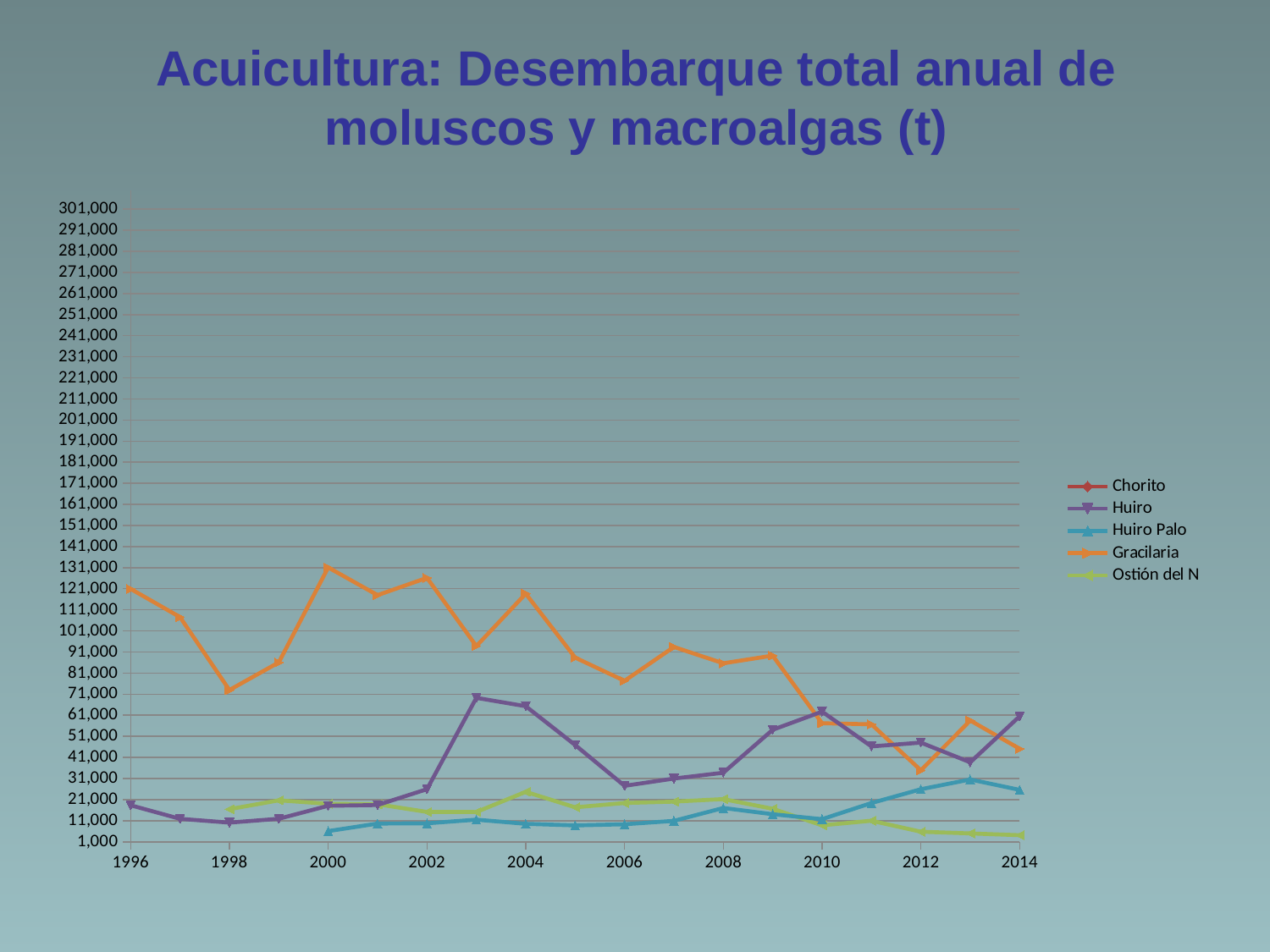
Does the Gracilaria series generally rise or fall from 1996 to 2014? fall Is the value for Gracilaria in 2000 greater or less than 121,000? greater How many year labels are shown on the x axis? 10 Which is larger in 2014, the value for Huiro or the value for Gracilaria? Huiro Is the value for Gracilaria in 1998 greater or less than 81,000? less Is the value for Huiro Palo in 2000 greater or less than 11,000? less Which series has the lowest value in 2014? Ostión del N In which year does the Gracilaria series reach its lowest value? 2012 What kind of chart is shown on the slide? line chart In which year does the Gracilaria series reach its highest value? 2000 How many series does the legend list? 5 Which series has the highest value in 2000? Gracilaria